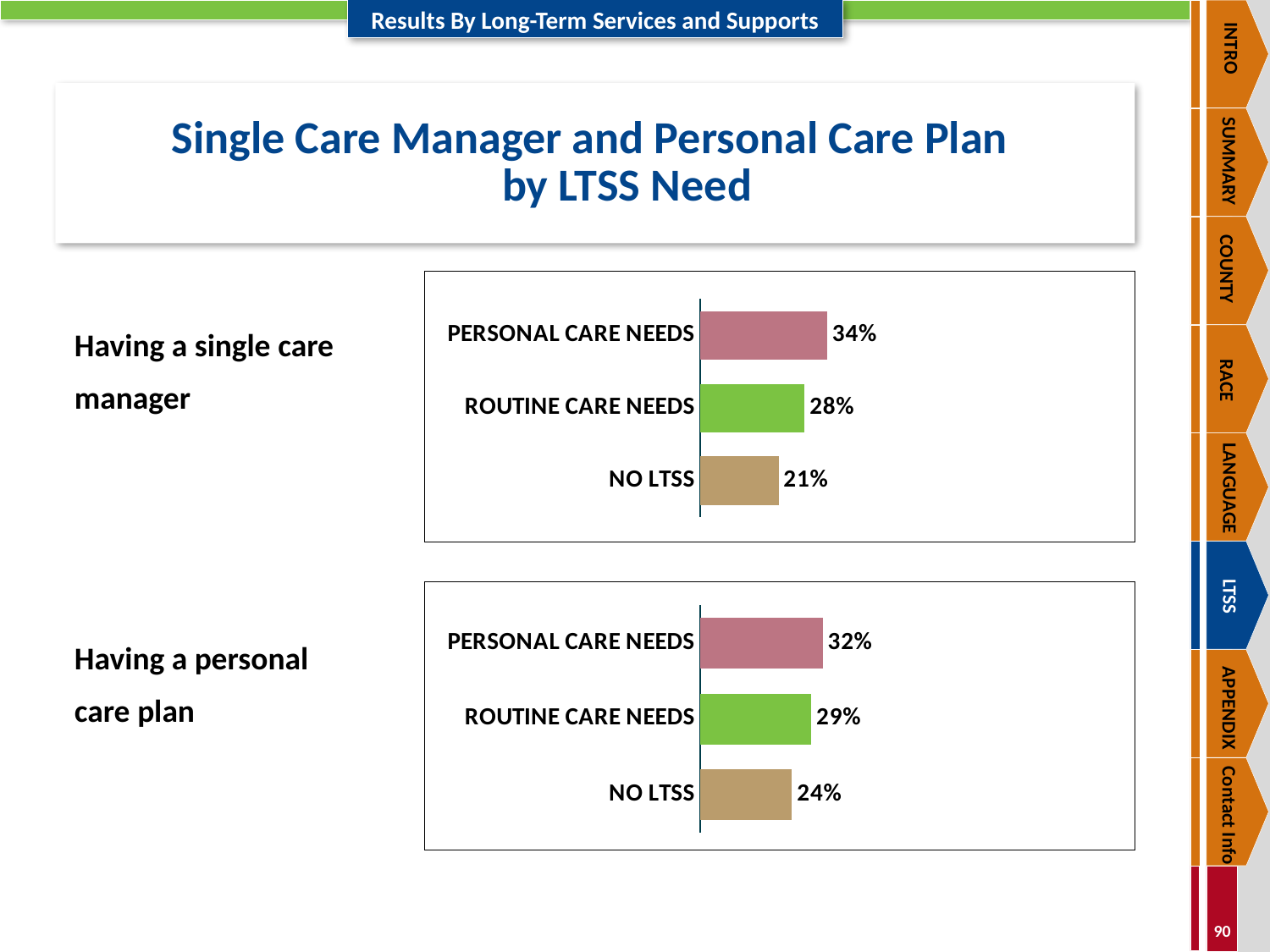
In the 'Having a single care manager' chart, what is the difference between PERSONAL CARE NEEDS and NO LTSS? 13% How many categories are shown in the 'Having a personal care plan' chart? 3 In the 'Having a single care manager' chart, which category has the highest value? PERSONAL CARE NEEDS In the 'Having a single care manager' chart, what is the value for NO LTSS? 21% In the 'Having a personal care plan' chart, what is the difference between PERSONAL CARE NEEDS and ROUTINE CARE NEEDS? 3% In the 'Having a single care manager' chart, which is larger: ROUTINE CARE NEEDS or NO LTSS? ROUTINE CARE NEEDS In the 'Having a personal care plan' chart, which category has the lowest value? NO LTSS In the 'Having a personal care plan' chart, what is the value for ROUTINE CARE NEEDS? 29% What is the title of the slide's chart section? Single Care Manager and Personal Care Plan by LTSS Need In the 'Having a personal care plan' chart, what is the value for NO LTSS? 24% In the 'Having a single care manager' chart, what is the value for PERSONAL CARE NEEDS? 34% What type of chart is the 'Having a single care manager' chart? Bar chart